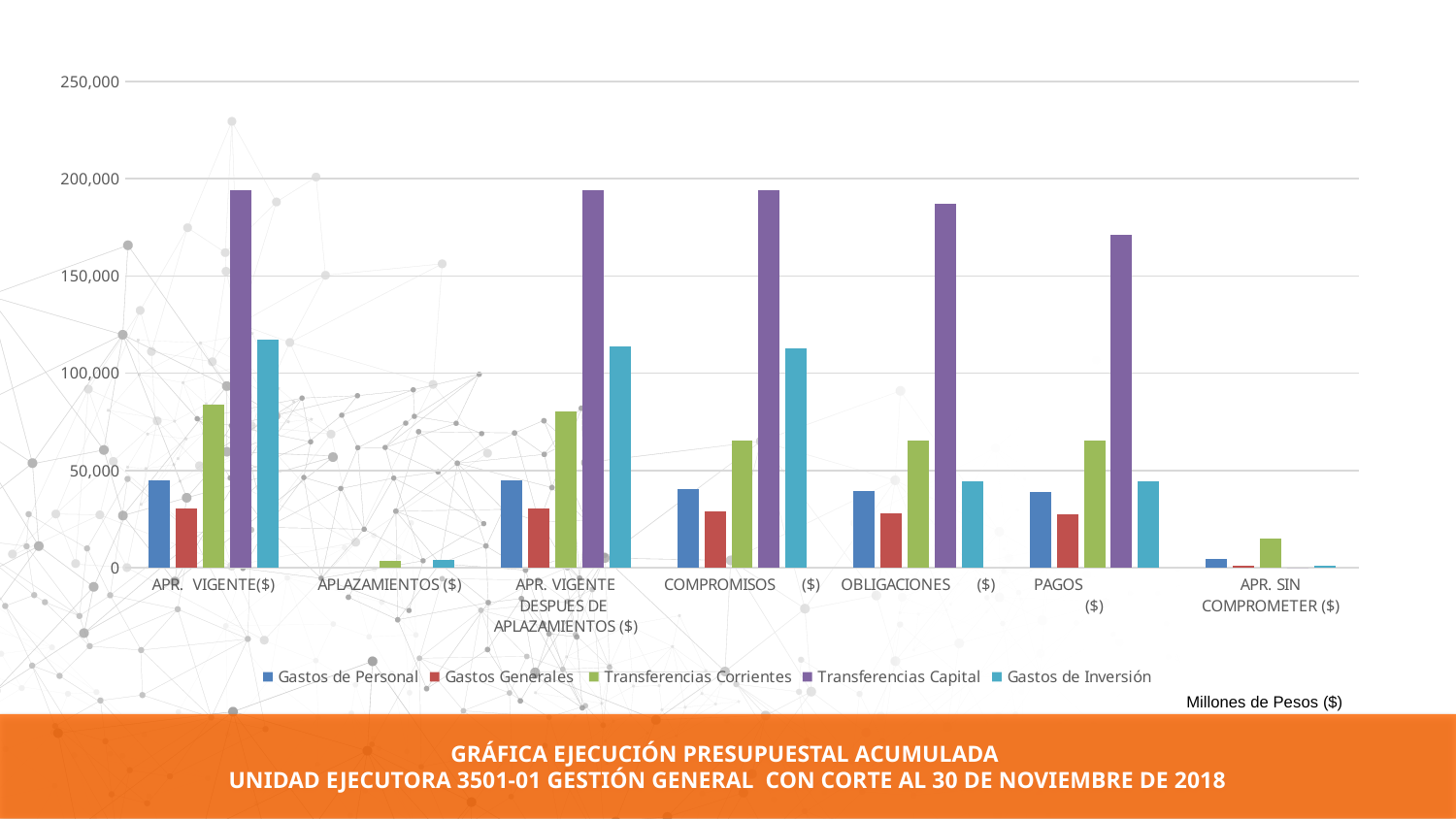
Is the value of Gastos de Inversión for APR. VIGENTE($) greater or less than 100,000? greater In the COMPROMISOS ($) category, which is larger: Gastos de Personal or Gastos Generales? Gastos de Personal Is the value of Gastos de Personal for COMPROMISOS ($) greater or less than 50,000? less Which is larger for Transferencias Capital: OBLIGACIONES ($) or PAGOS ($)? OBLIGACIONES ($) Is the value of Transferencias Capital for PAGOS ($) greater or less than 200,000? less What kind of chart is shown on the slide? bar chart How many categories are shown along the x axis? 7 What unit is stated for the values in the chart? Millones de Pesos ($) How many series does the legend list? 5 Which series has the highest value in the APR. VIGENTE($) category? Transferencias Capital